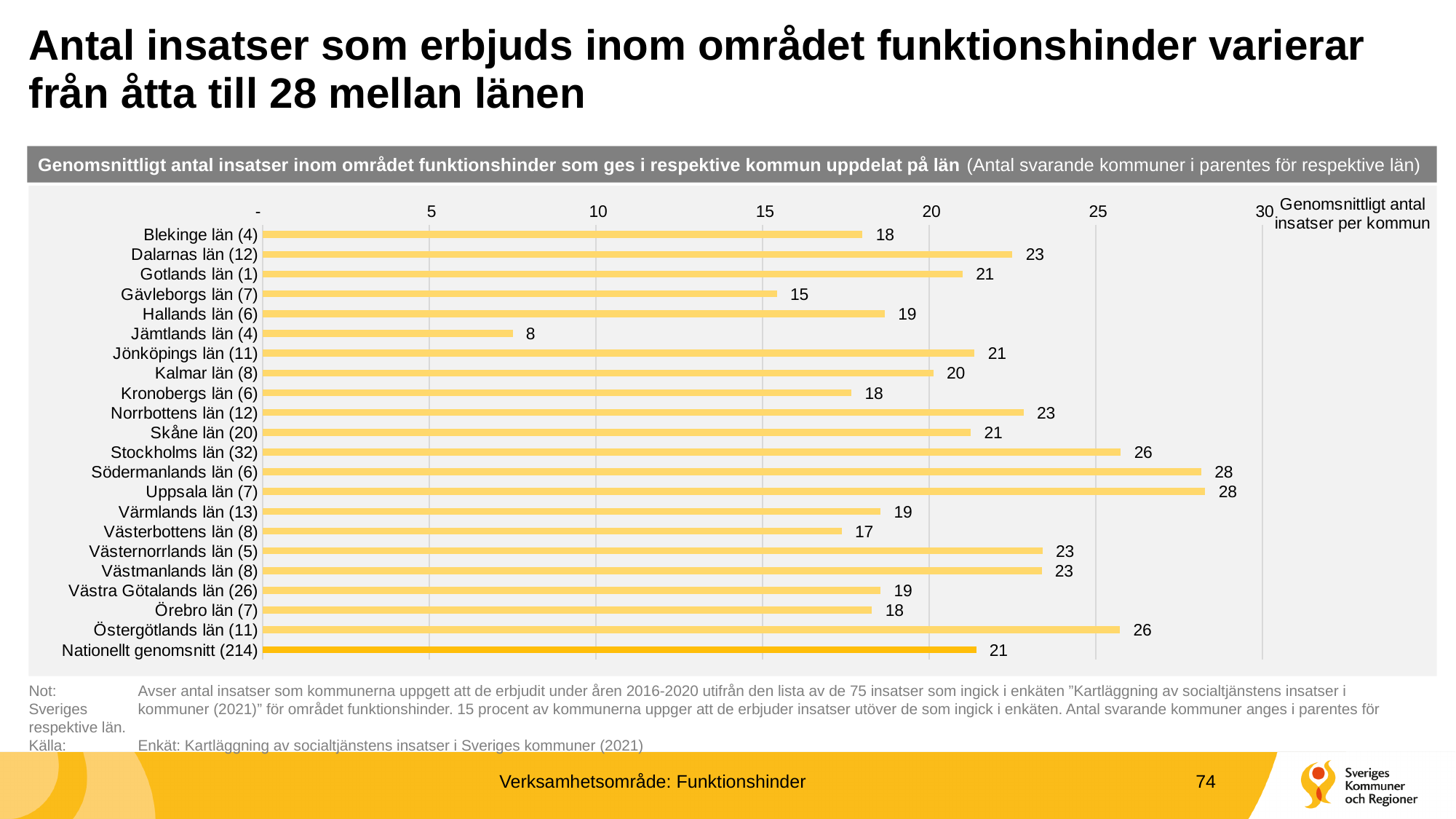
What is the difference between the values for Uppsala län (7) and Västerbottens län (8)? 11 What is the value for Gävleborgs län (7)? 15 What is the value for Nationellt genomsnitt (214)? 21 Which is larger, the value for Dalarnas län (12) or the value for Kalmar län (8)? Dalarnas län (12) What is the label shown at the top right of the chart's axis? Genomsnittligt antal insatser per kommun What is the value for Jämtlands län (4)? 8 What is the difference between the values for Södermanlands län (6) and Jämtlands län (4)? 20 Which category has the lowest value? Jämtlands län (4) What kind of chart is shown on the slide? bar chart Is the value for Östergötlands län (11) greater or less than 25? greater What is the value for Stockholms län (32)? 26 How many bars are plotted in the chart? 22